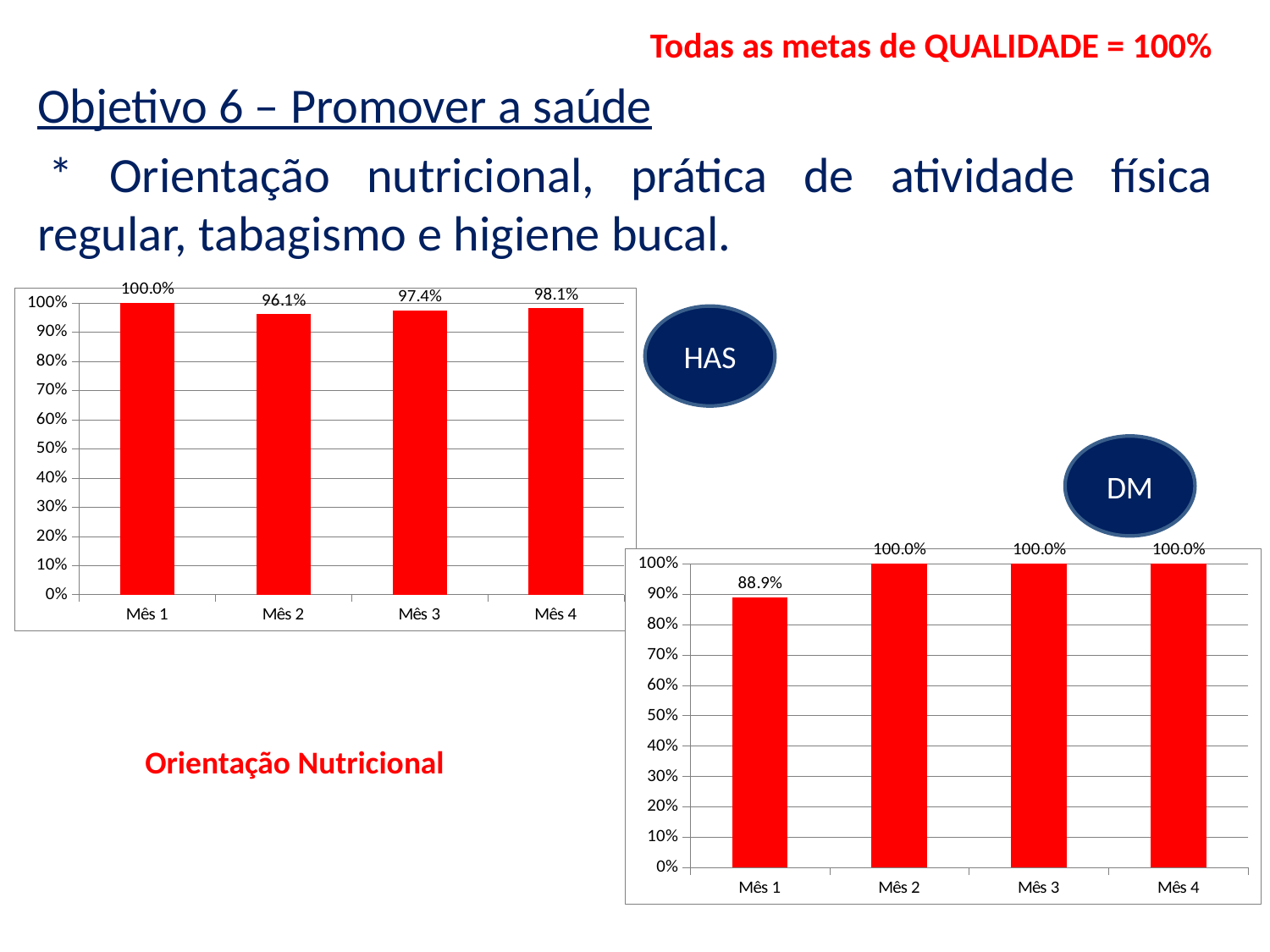
In the HAS chart (upper left), what is the value for Mês 2? 96.1% In the DM chart (lower right), what is the value for Mês 1? 88.9% What type of chart is the HAS chart (upper left)? Bar chart In the HAS chart (upper left), which month has the lowest value? Mês 2 In the DM chart (lower right), is the value for Mês 1 greater or less than 90%? less In the HAS chart (upper left), what is the difference between Mês 1 and Mês 2? 3.9% In the DM chart (lower right), what is the difference between Mês 2 and Mês 1? 11.1% In the HAS chart (upper left), which month has the highest value? Mês 1 How many months are shown in the DM chart (lower right)? 4 In the HAS chart (upper left), what is the value for Mês 4? 98.1% In the DM chart (lower right), which month has the lowest value? Mês 1 In the HAS chart (upper left), which is larger, the value for Mês 3 or Mês 2? Mês 3